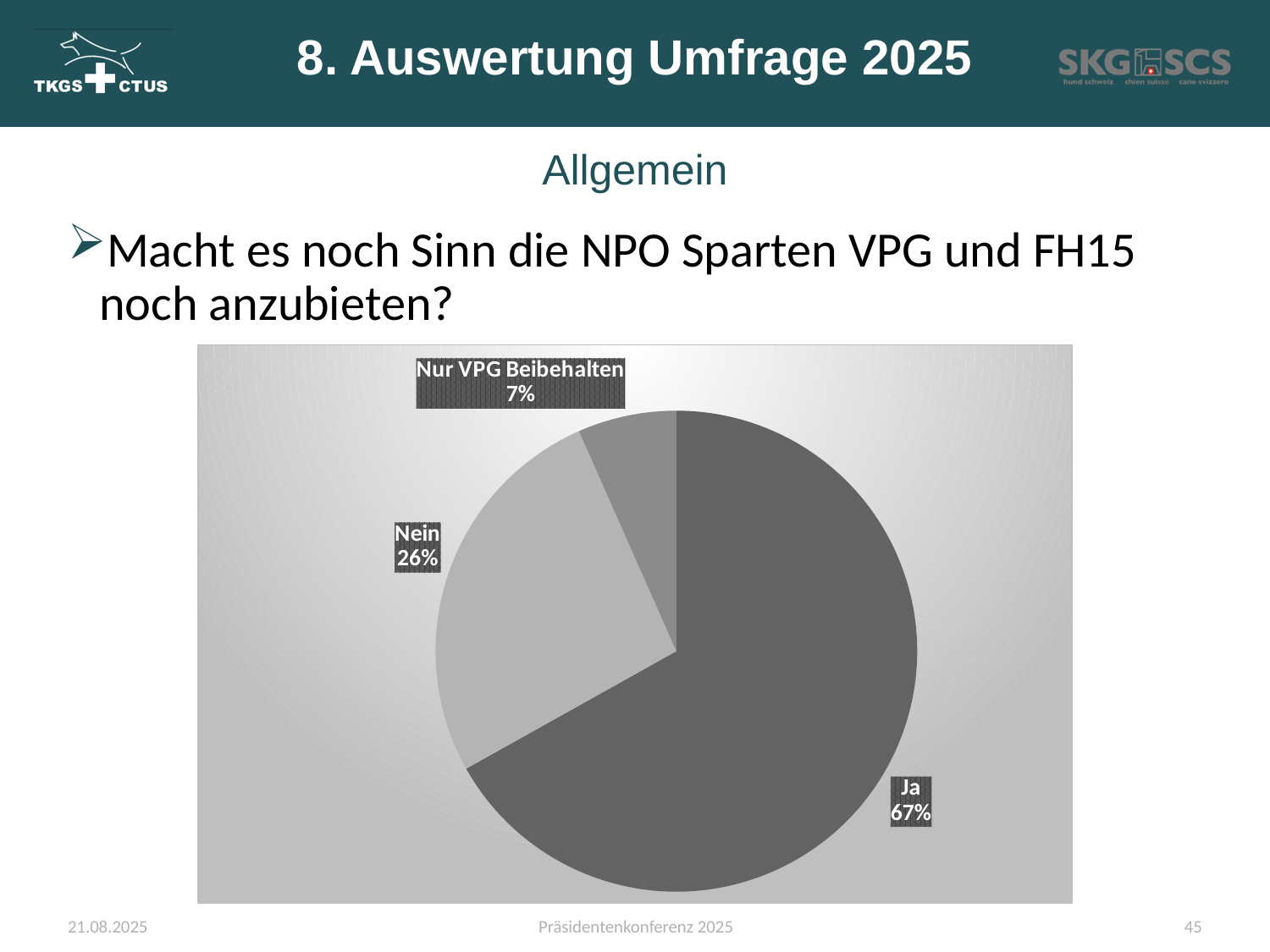
What share of the pie does the "Ja" slice represent? 67% Which slice of the pie is the largest? Ja Which is larger, the "Nein" slice or the "Nur VPG Beibehalten" slice? Nein What share of the pie does the "Nein" slice represent? 26% What share of the pie does the "Nur VPG Beibehalten" slice represent? 7% What question does the pie chart on the slide summarise responses to? Macht es noch Sinn die NPO Sparten VPG und FH15 noch anzubieten? What is the difference in percentage points between the "Ja" and "Nein" slices? 41 What kind of chart is shown on the slide? pie chart How many slices does the pie chart have? 3 Which is larger, the "Ja" slice or the "Nein" slice? Ja Which slice of the pie is the smallest? Nur VPG Beibehalten What is the difference in percentage points between the "Nein" and "Nur VPG Beibehalten" slices? 19